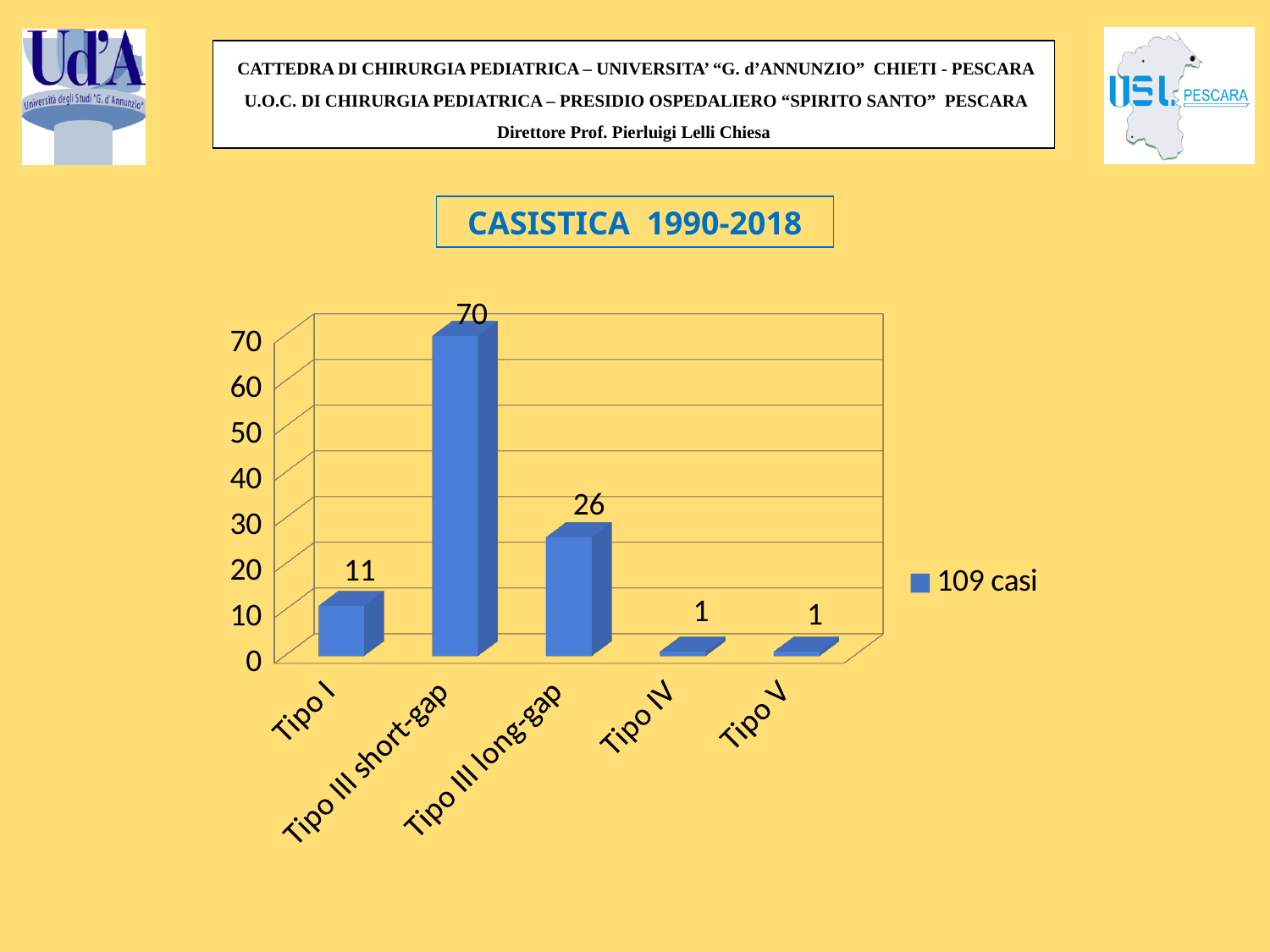
How many series does the legend list? 1 What kind of chart is shown on the slide? bar chart What is the value for Tipo III short-gap? 70 What is the difference between the values for Tipo III short-gap and Tipo III long-gap? 44 What is the value for Tipo III long-gap? 26 What is the value for Tipo I? 11 What is the difference between the values for Tipo III long-gap and Tipo I? 15 What is the value for Tipo IV? 1 Which is larger, the value for Tipo I or the value for Tipo III long-gap? Tipo III long-gap How many categories are shown on the x axis? 5 Which category has the highest value? Tipo III short-gap What is the legend entry of the chart? 109 casi